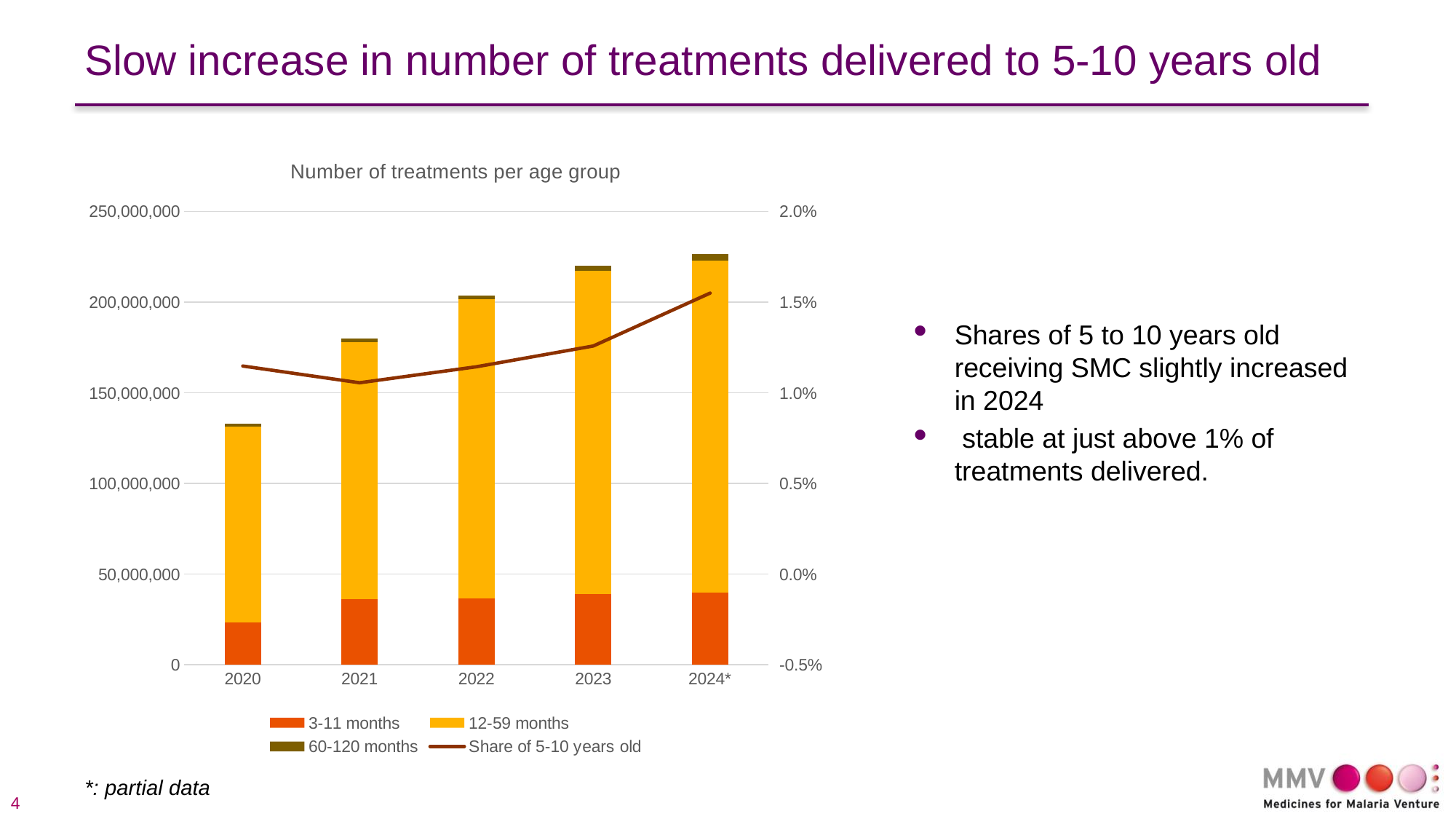
How many years are shown on the x axis of the chart? 5 Which year has the lowest value on the 'Share of 5-10 years old' line? 2021 Is the share of 5-10 years old in 2021 greater or less than 1.0%? greater Do the total number of treatments rise or fall from 2020 to 2024*? rise Is the total number of treatments in 2020 greater or less than 150,000,000? less What is the title of the chart? Number of treatments per age group What kind of chart is shown on the slide? Stacked bar chart with a line Is the total number of treatments in 2024* greater or less than 200,000,000? greater Which year has the tallest stacked bar for number of treatments? 2024* Which year has the shortest stacked bar for number of treatments? 2020 How many series does the chart legend list? 4 Is the 3-11 months segment larger in 2020 or in 2021? 2021